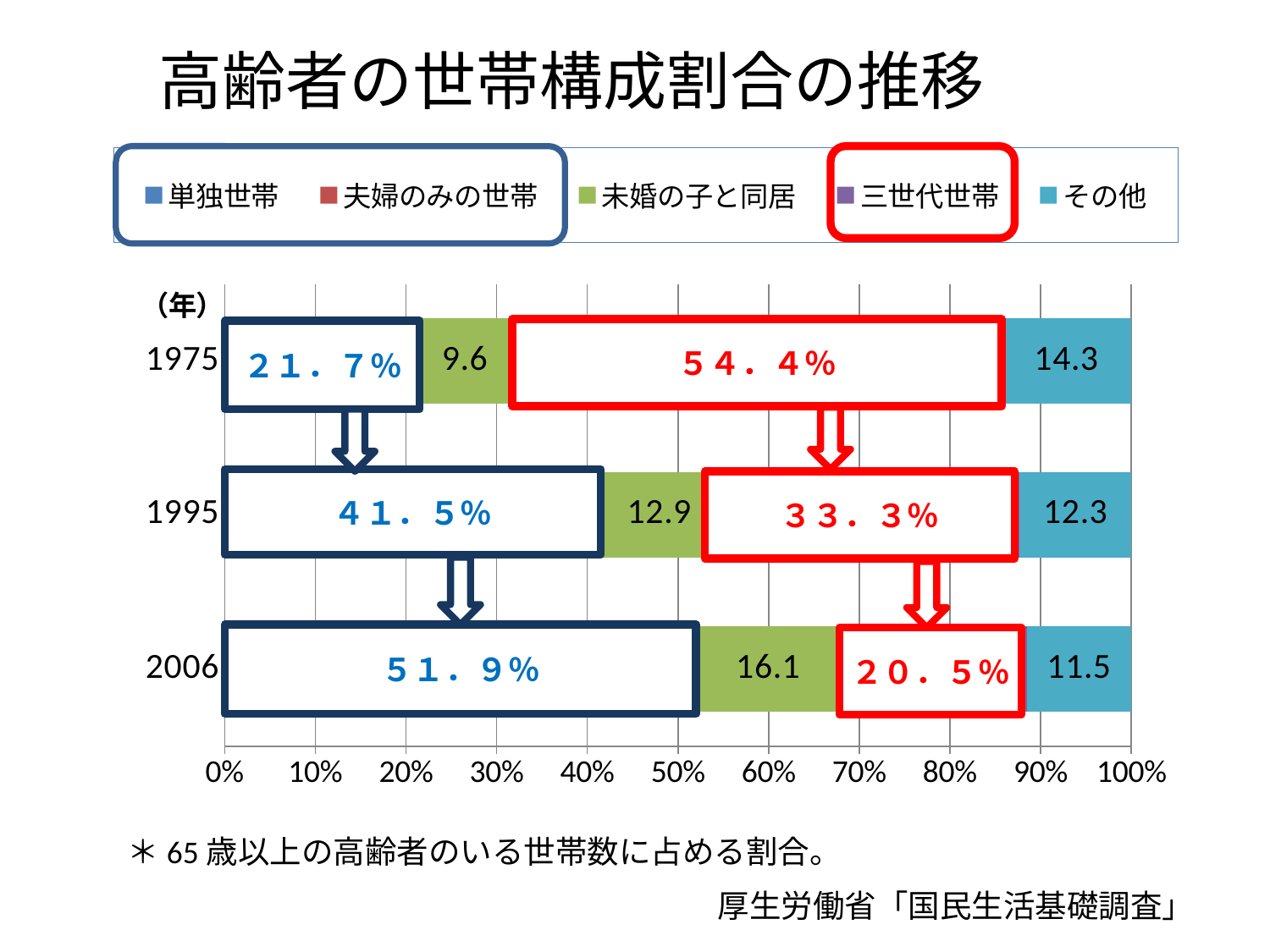
What is the value for その他 in 2006? 11.5 How many series does the legend list? 5 In which year is the share of 三世代世帯 highest? 1975 In 2006, which is larger: 未婚の子と同居 or その他? 未婚の子と同居 Does the share of 三世代世帯 rise or fall from 1975 to 2006? fall How many years are plotted on the chart? 3 What value is shown in the blue-outlined box for 1995? 41.5% Does the share of 未婚の子と同居 rise or fall from 1975 to 2006? rise What is the value for 未婚の子と同居 in 1975? 9.6 What is the value for 三世代世帯 in 1995? 33.3% By how many percentage points did the share of 三世代世帯 fall from 1975 to 2006? 33.9 What kind of chart is shown on the slide? stacked bar chart